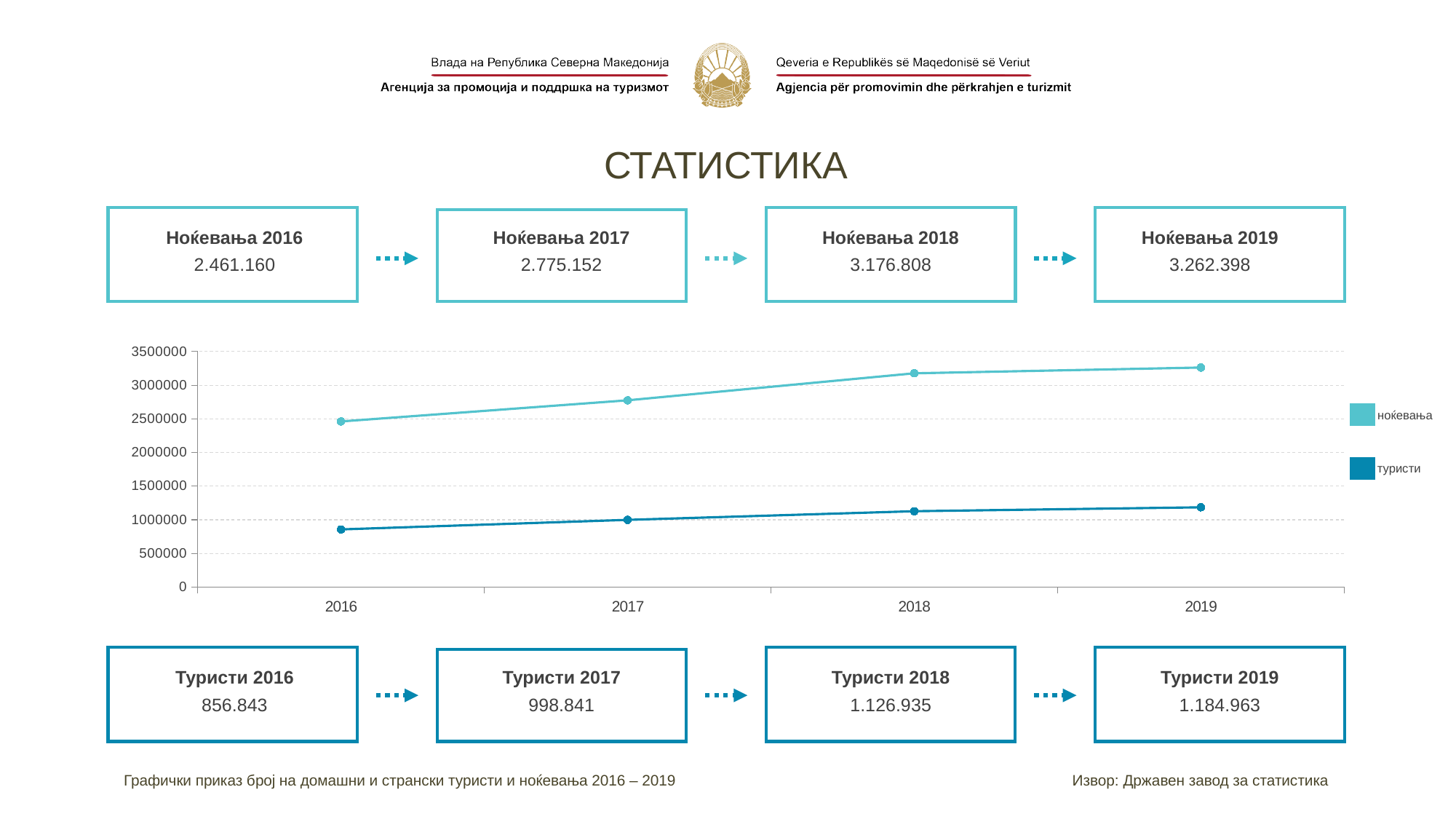
Which is larger in 2019, ноќевања or туристи? ноќевања What is the difference between ноќевања in 2019 and ноќевања in 2016? 801.238 In which year is the туристи series at its lowest? 2016 In which year is the ноќевања series at its highest? 2019 Is the value for туристи in 2016 greater or less than 1000000? less Does the ноќевања series rise or fall from 2016 to 2019? rise What is the difference between туристи in 2019 and туристи in 2016? 328.120 What is the value of ноќевања for 2018? 3.176.808 How many years are plotted along the x axis of the chart? 4 How many series does the chart legend list? 2 What type of chart is shown on the slide? line chart What is the value of туристи for 2017? 998.841